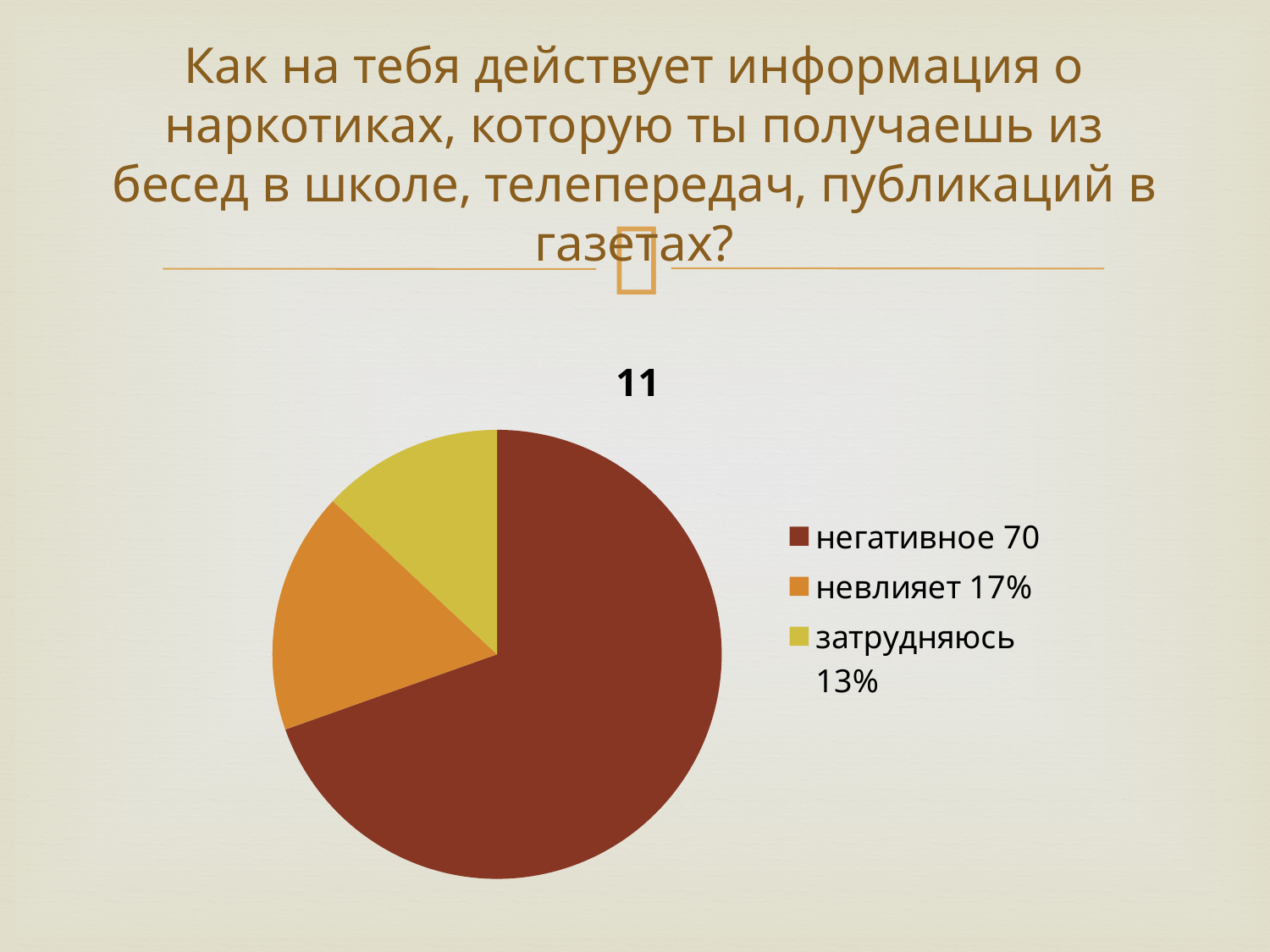
Is the 'негативное' slice more or less than half of the pie? more What number is shown in the legend next to 'негативное'? 70 What kind of chart is shown on the slide? pie chart What percentage is shown in the legend for 'затрудняюсь'? 13% Which legend entry corresponds to the smallest slice of the pie? затрудняюсь 13% How many slices does the pie chart have? 3 What percentage is shown in the legend for 'невлияет'? 17% Which slice is larger: 'невлияет' or 'затрудняюсь'? невлияет What is the title shown above the pie chart? 11 What is the difference between the percentages shown for 'невлияет' and 'затрудняюсь'? 4% What colour is the slice for 'негативное'? dark red Which legend entry corresponds to the largest slice of the pie? негативное 70